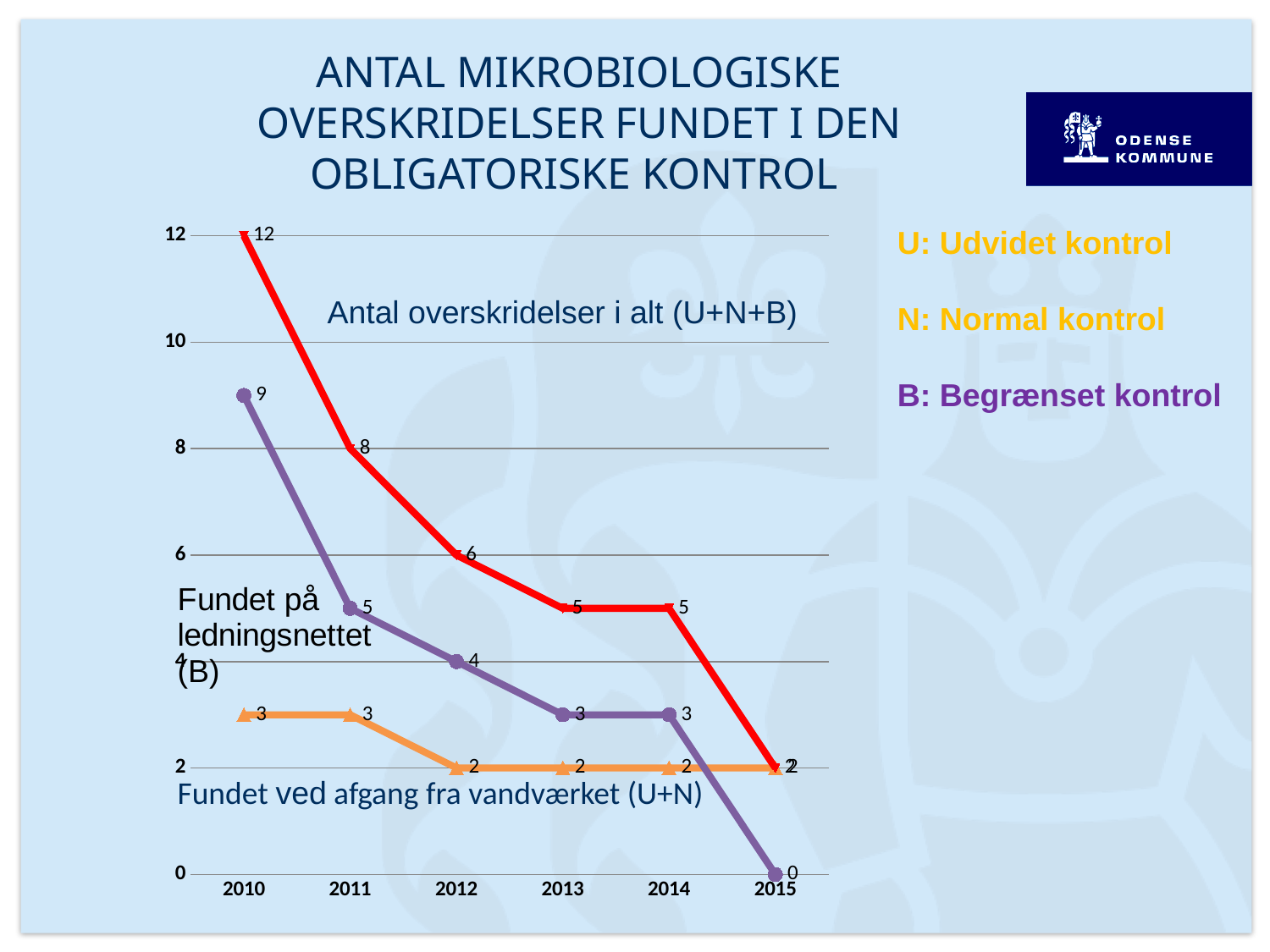
What is the value of 'Antal overskridelser i alt (U+N+B)' in 2010? 12 What colour is the line for 'Antal overskridelser i alt (U+N+B)'? red In which year is 'Antal overskridelser i alt (U+N+B)' highest? 2010 Which is larger in 2013: 'Fundet på ledningsnettet (B)' or 'Fundet ved afgang fra vandværket (U+N)'? Fundet på ledningsnettet (B) Does 'Antal overskridelser i alt (U+N+B)' rise or fall from 2010 to 2015? fall In which year is 'Fundet på ledningsnettet (B)' lowest? 2015 What is the value of 'Fundet ved afgang fra vandværket (U+N)' in 2012? 2 What kind of chart is shown on the slide? line chart What is the difference between 'Antal overskridelser i alt (U+N+B)' in 2010 and in 2011? 4 What is the value of 'Fundet på ledningsnettet (B)' in 2011? 5 How many years are shown on the x axis? 6 What is the value of 'Fundet på ledningsnettet (B)' in 2015? 0